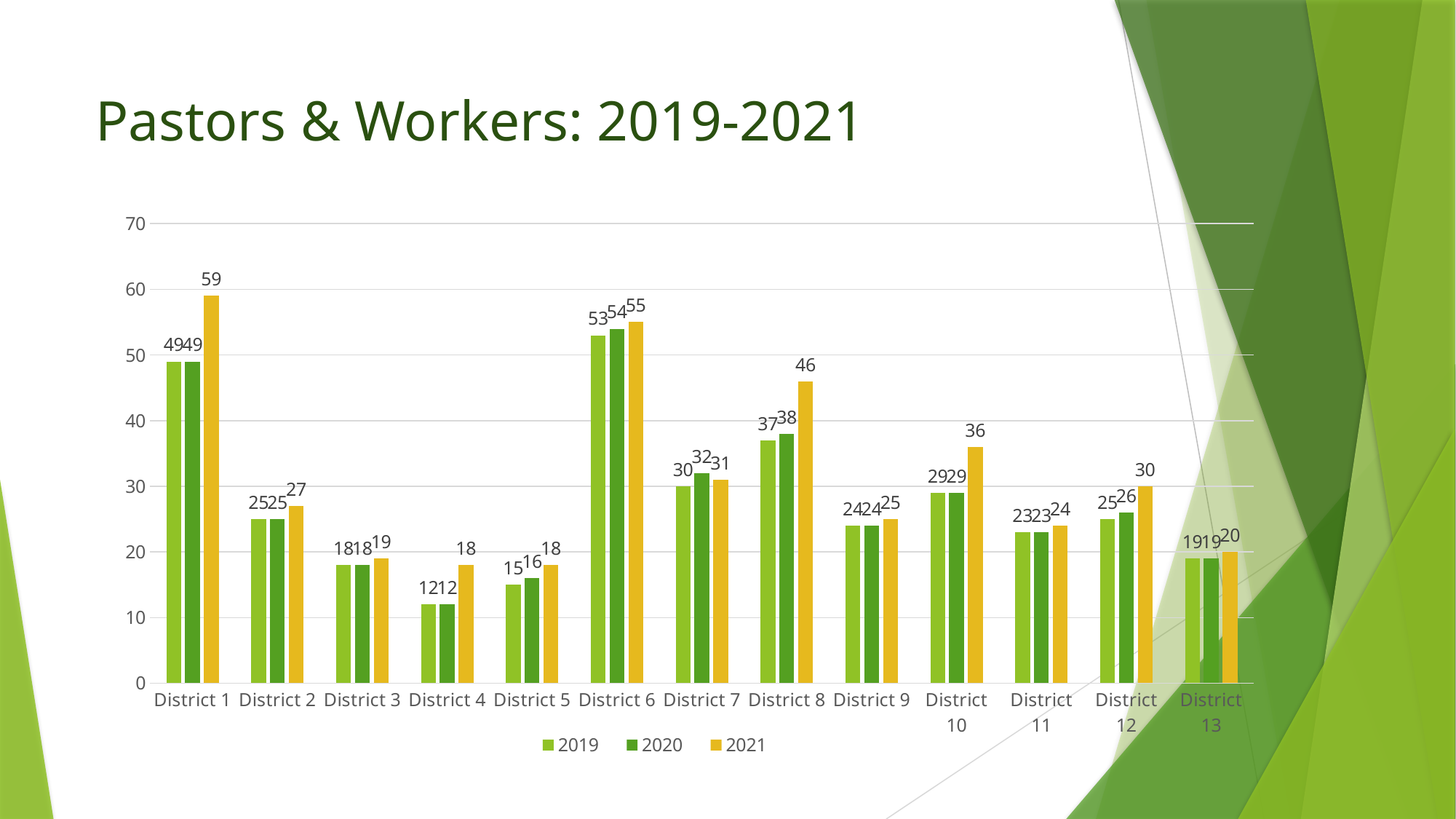
How many series does the legend list? 3 What is the value for District 8 in 2020? 38 Which district has the highest value in 2021? District 1 What is the value for District 4 in 2019? 12 What is the difference between the 2021 and 2019 values for District 1? 10 What kind of chart is shown on the slide? Bar chart What is the difference between the 2021 values for District 6 and District 8? 9 What is the title of the chart? Pastors & Workers: 2019-2021 What is the value for District 1 in 2021? 59 Which district has the lowest value in 2019? District 4 How many districts are shown on the x axis? 13 Which is larger: the 2021 value for District 10 or the 2021 value for District 7? District 10